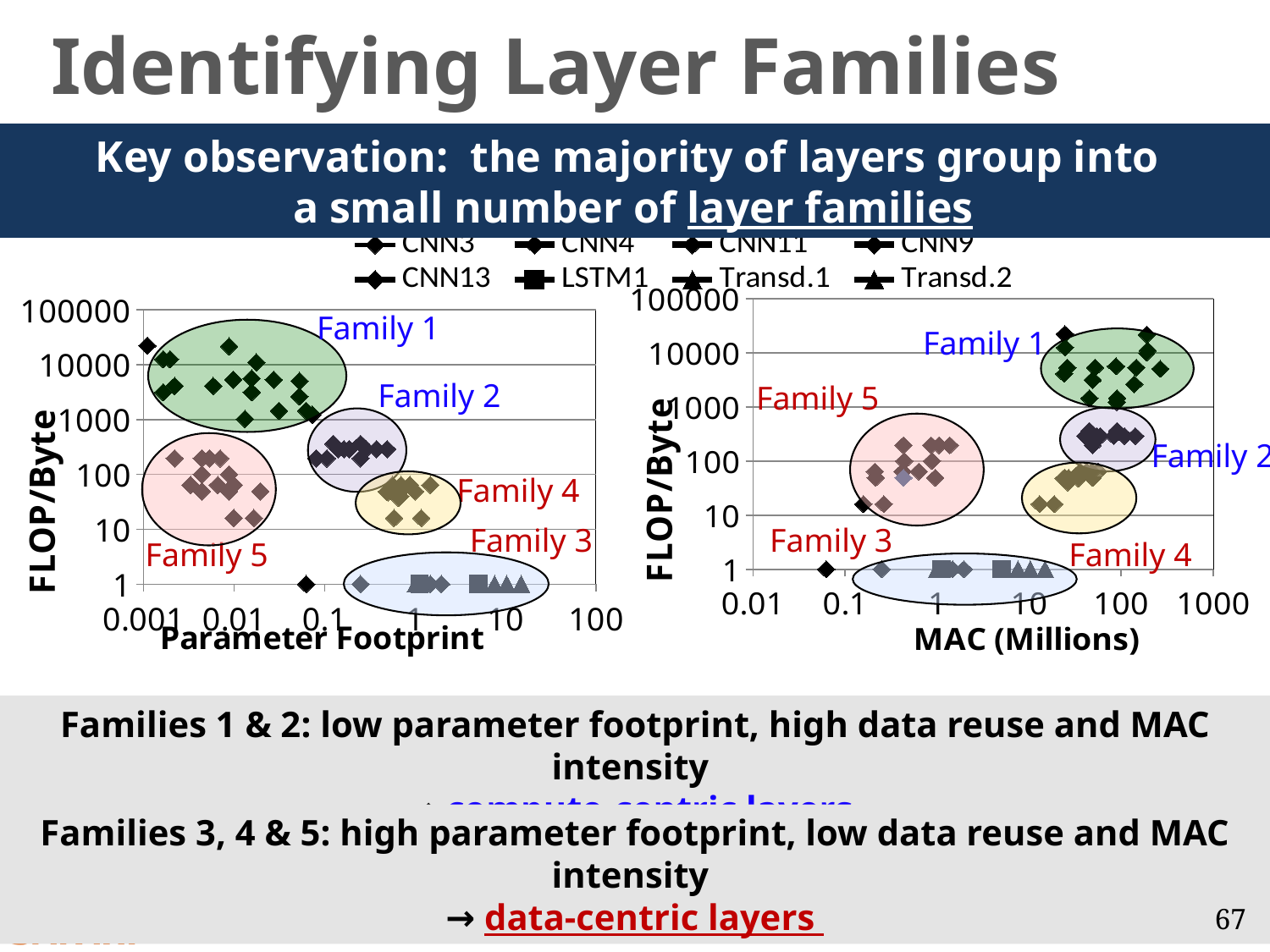
How many layer families are circled in the left chart? 5 In the left chart, are the FLOP/Byte values of the Family 3 cluster greater or less than 10? less In the right chart, are the MAC (Millions) values of the Family 1 cluster greater or less than 10? greater What is the x-axis label of the right chart? MAC (Millions) In the left chart, which family cluster has the highest FLOP/Byte values, Family 1 or Family 3? Family 1 In the right chart, are the FLOP/Byte values of the Family 4 cluster greater or less than 1000? less How many series does the shared legend list for the charts? 8 What is the y-axis label of the left chart? FLOP/Byte In the right chart, which family cluster has the lowest FLOP/Byte values? Family 3 What kind of chart is the right chart with x axis MAC (Millions)? scatter chart What kind of chart is the left chart with x axis Parameter Footprint? scatter chart